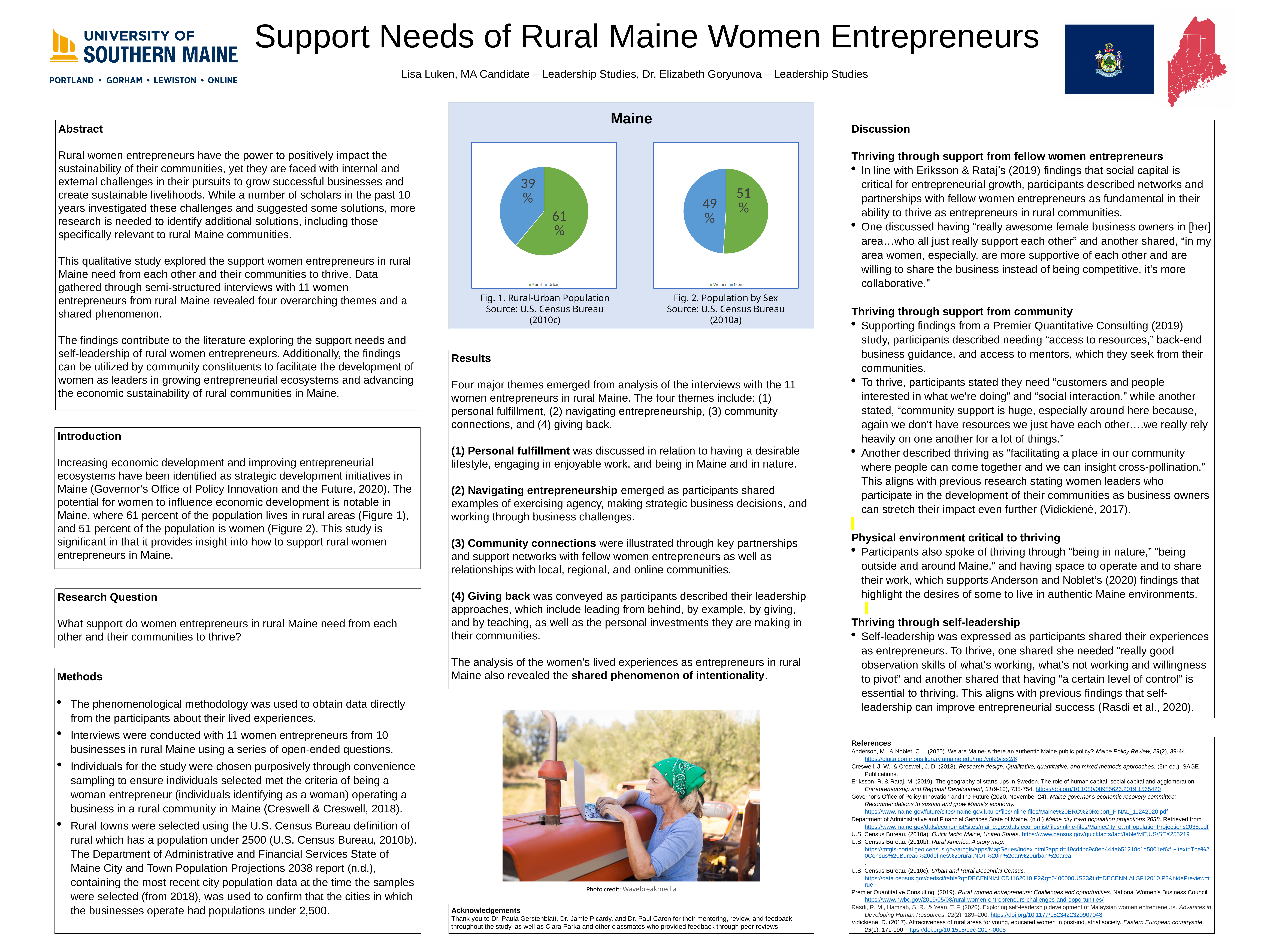
In Fig. 2 (Population by Sex), what colour is the Women slice? Green How many slices does the pie in Fig. 2 (Population by Sex) have? 2 In Fig. 2 (Population by Sex), what share of the population is men? 49% How many entries does the legend of Fig. 1 (Rural-Urban Population) list? 2 What type of chart is Fig. 1 (Rural-Urban Population)? Pie chart In Fig. 2 (Population by Sex), what is the difference in percentage points between the women and men shares? 2 In Fig. 2 (Population by Sex), which category has the smaller share? Men In Fig. 1 (Rural-Urban Population), what share of the population is rural? 61% In Fig. 1 (Rural-Urban Population), which category has the larger share? Rural In Fig. 2 (Population by Sex), what share of the population is women? 51% In Fig. 1 (Rural-Urban Population), what is the difference in percentage points between the rural and urban shares? 22 In Fig. 1 (Rural-Urban Population), what share of the population is urban? 39%